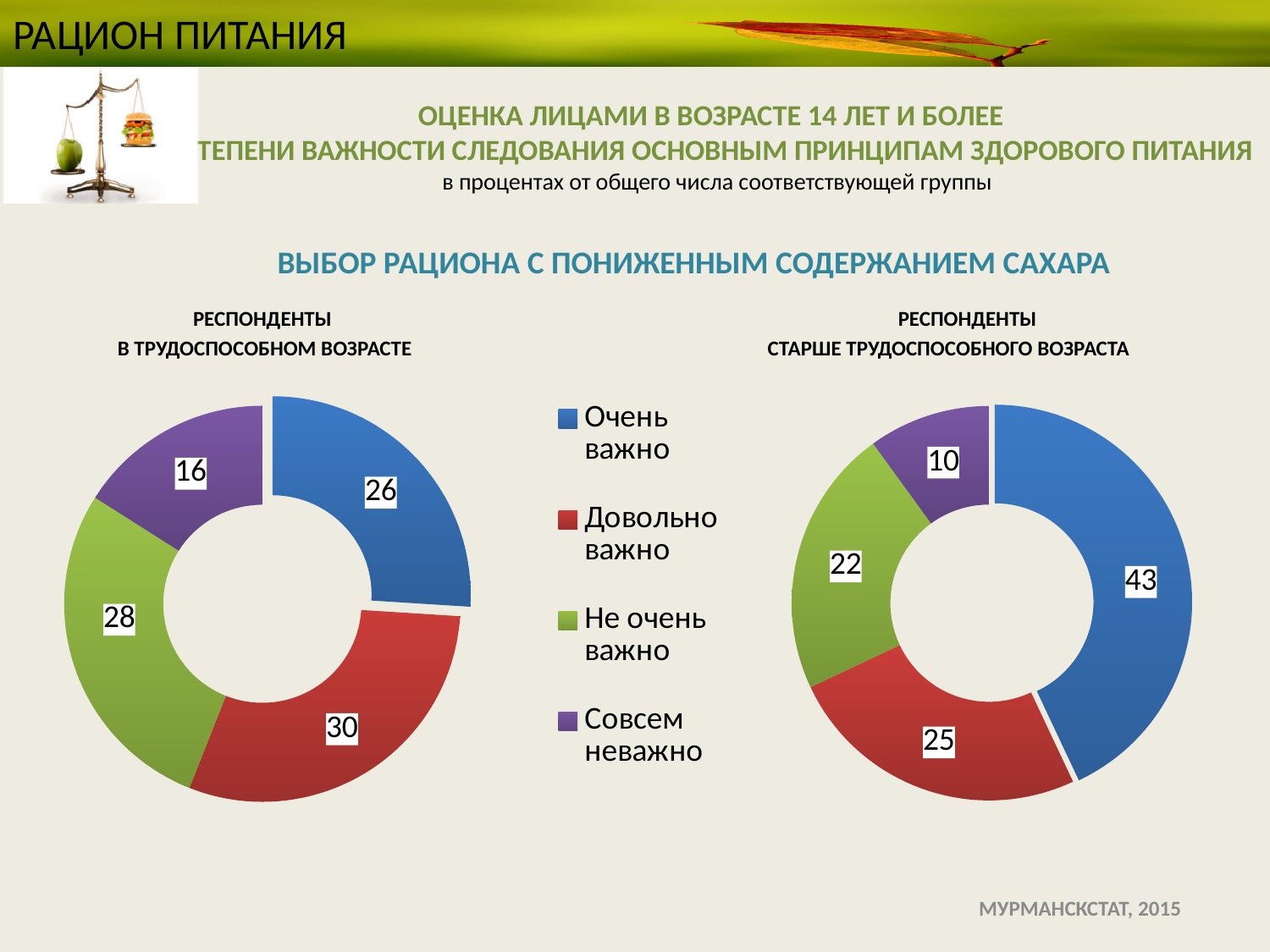
How many categories does the left chart (РЕСПОНДЕНТЫ В ТРУДОСПОСОБНОМ ВОЗРАСТЕ) show? 4 On the right chart (РЕСПОНДЕНТЫ СТАРШЕ ТРУДОСПОСОБНОГО ВОЗРАСТА), what is the value for «Совсем неважно»? 10 On the left chart (РЕСПОНДЕНТЫ В ТРУДОСПОСОБНОМ ВОЗРАСТЕ), what is the value for «Очень важно»? 26 Which chart has the larger value for «Очень важно»: the left one (В ТРУДОСПОСОБНОМ ВОЗРАСТЕ) or the right one (СТАРШЕ ТРУДОСПОСОБНОГО ВОЗРАСТА)? the right one (СТАРШЕ ТРУДОСПОСОБНОГО ВОЗРАСТА) On the left chart (РЕСПОНДЕНТЫ В ТРУДОСПОСОБНОМ ВОЗРАСТЕ), which is larger: «Не очень важно» or «Совсем неважно»? Не очень важно What is the title shown above the two charts? ВЫБОР РАЦИОНА С ПОНИЖЕННЫМ СОДЕРЖАНИЕМ САХАРА On the left chart (РЕСПОНДЕНТЫ В ТРУДОСПОСОБНОМ ВОЗРАСТЕ), which category has the largest value? Довольно важно What colour represents «Довольно важно» in the legend? red What kind of chart is used for РЕСПОНДЕНТЫ СТАРШЕ ТРУДОСПОСОБНОГО ВОЗРАСТА? doughnut (pie) chart On the right chart (РЕСПОНДЕНТЫ СТАРШЕ ТРУДОСПОСОБНОГО ВОЗРАСТА), what is the difference between «Очень важно» and «Довольно важно»? 18 On the left chart (РЕСПОНДЕНТЫ В ТРУДОСПОСОБНОМ ВОЗРАСТЕ), what is the value for «Не очень важно»? 28 On the right chart (РЕСПОНДЕНТЫ СТАРШЕ ТРУДОСПОСОБНОГО ВОЗРАСТА), which category has the smallest value? Совсем неважно